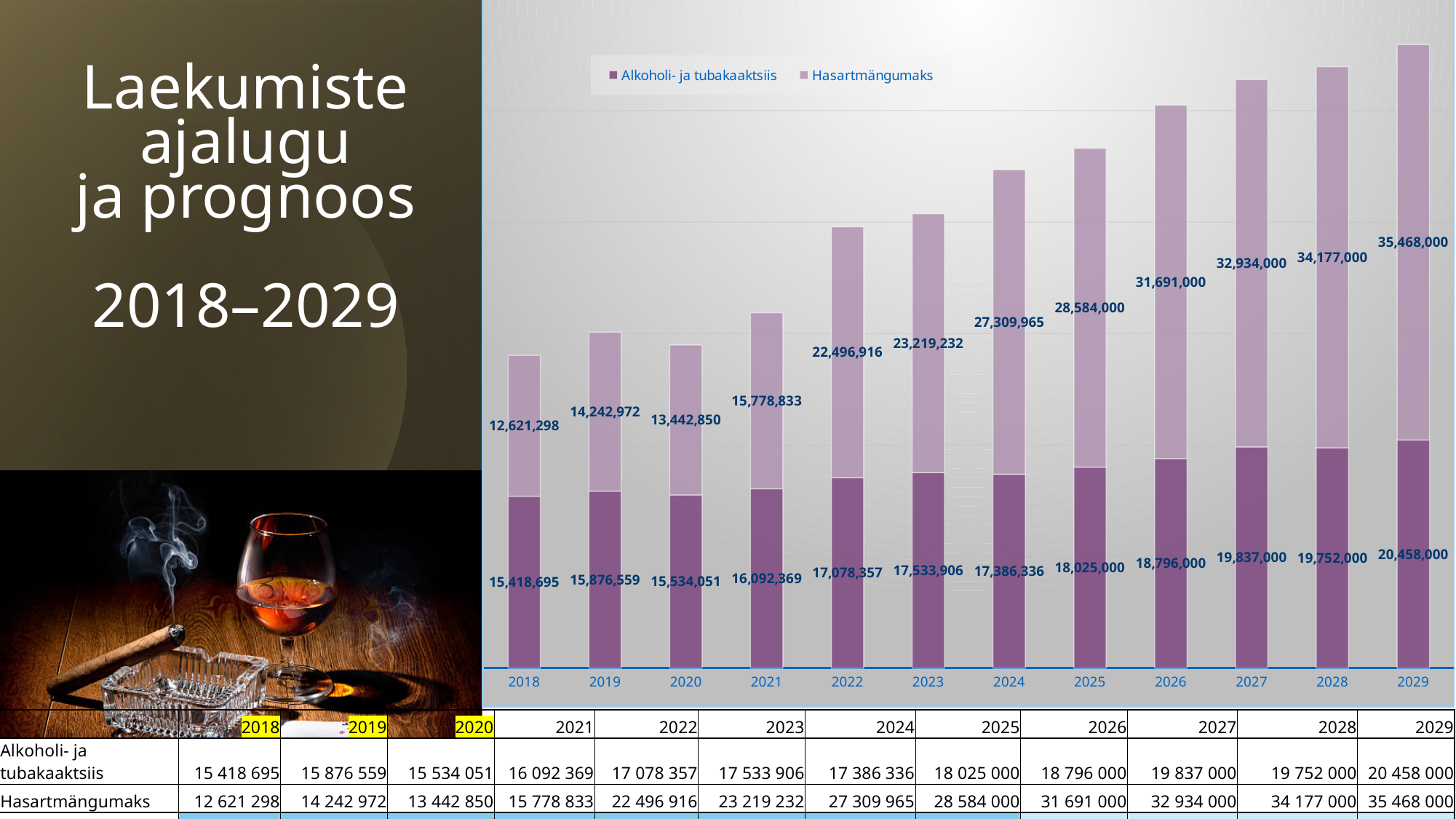
How many years are shown on the x axis of the chart? 12 In which year is Hasartmängumaks lowest? 2018 What is the total of the stacked bar for 2029? 55,926,000 In which year is Hasartmängumaks highest? 2029 What is the value of Alkoholi- ja tubakaaktsiis for 2018? 15,418,695 What is the difference between Hasartmängumaks in 2029 and in 2018? 22,846,702 What is the value of Hasartmängumaks for 2029? 35,468,000 What is the value of Hasartmängumaks for 2022? 22,496,916 In 2018, which is larger: Alkoholi- ja tubakaaktsiis or Hasartmängumaks? Alkoholi- ja tubakaaktsiis What kind of chart is shown on the slide? Stacked bar chart What is the difference between Alkoholi- ja tubakaaktsiis in 2029 and in 2028? 706,000 How many series does the chart legend list? 2